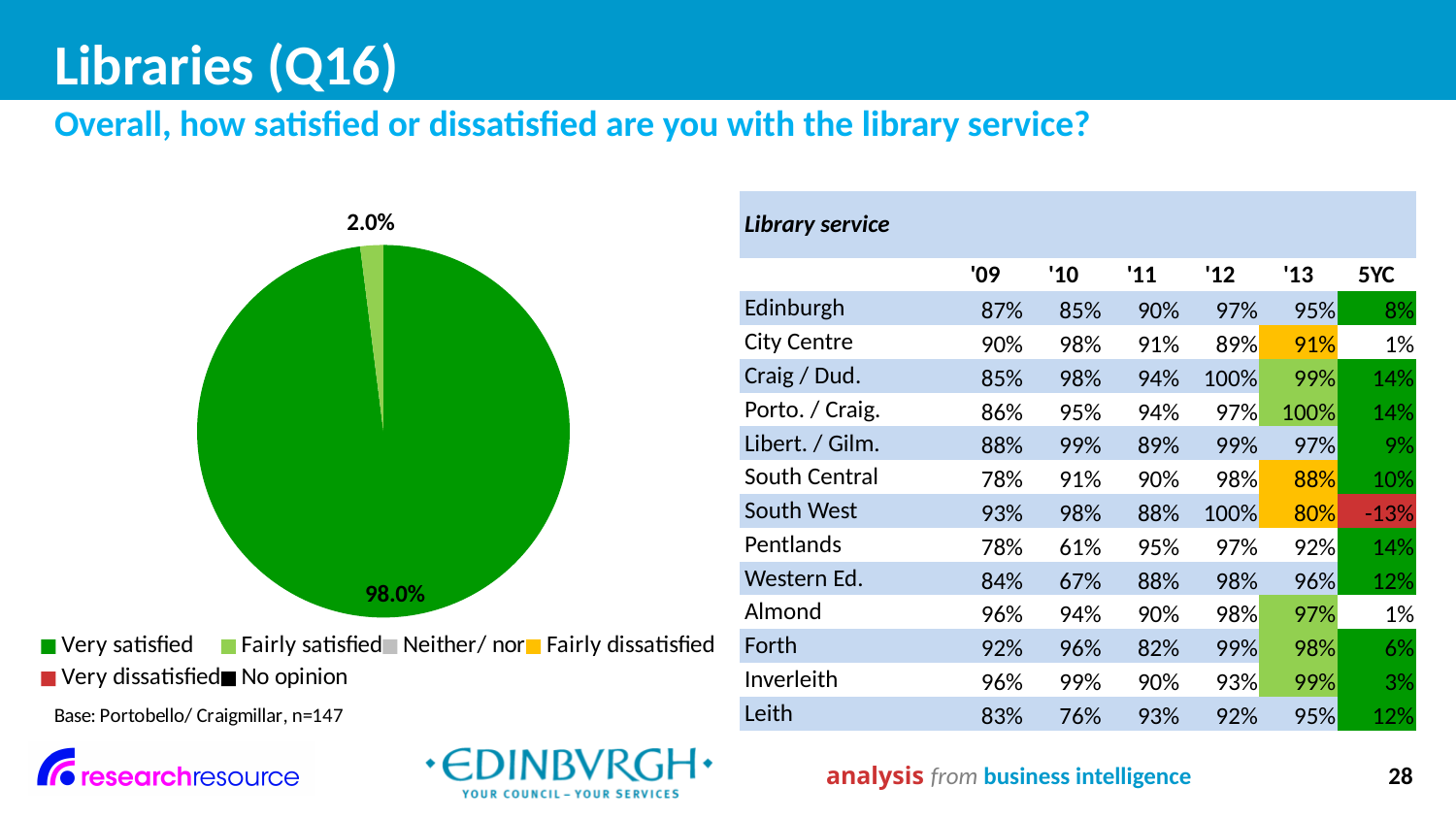
Which is larger in the pie chart: 'Very satisfied' or 'Fairly satisfied'? Very satisfied What do the two labelled slices of the pie chart add up to? 100.0% What percentage of respondents are 'Very satisfied' with the library service according to the pie chart? 98.0% What percentage of respondents are 'Fairly satisfied' according to the pie chart? 2.0% Is the 'Very satisfied' share in the pie chart greater or less than 50%? greater What kind of chart is shown on the slide? Pie chart Of the two labelled slices in the pie chart, which is the smaller? Fairly satisfied What is the base (sample) stated beneath the pie chart? Portobello/ Craigmillar, n=147 Which category has the largest slice in the pie chart? Very satisfied What colour is the 'Very satisfied' slice in the pie chart? Green What is the difference between the 'Very satisfied' and 'Fairly satisfied' shares in the pie chart? 96.0% How many categories does the pie chart's legend list? 6